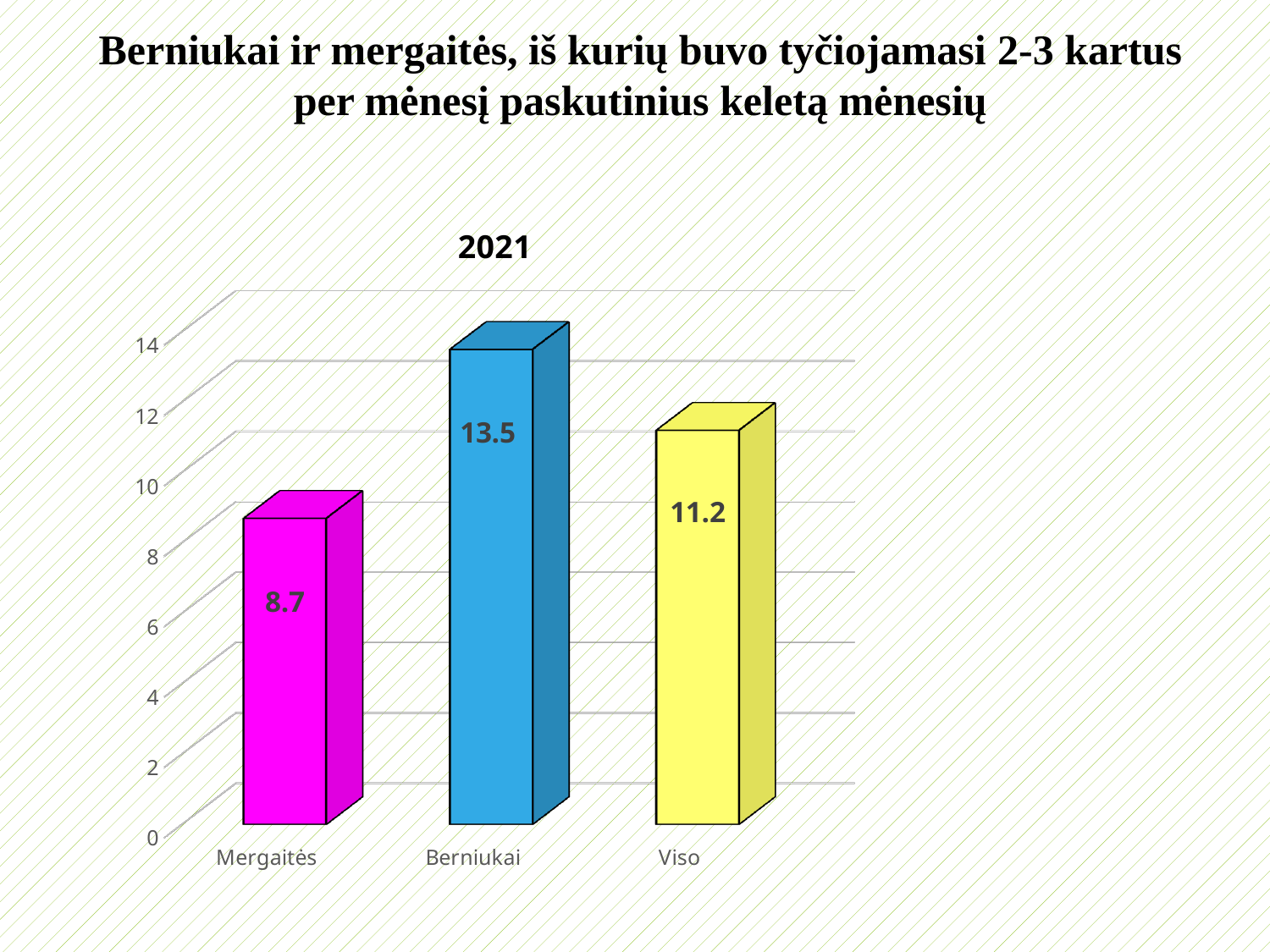
How many categories are shown on the x axis? 3 What is the value for Mergaitės? 8.7 What is the value for Berniukai? 13.5 What kind of chart is shown on the slide? bar chart Is the value for Berniukai greater or less than 12? greater Which category has the highest value? Berniukai What is the value for Viso? 11.2 What is the difference between the values for Viso and Mergaitės? 2.5 Which is larger, the value for Viso or the value for Mergaitės? Viso Which category has the lowest value? Mergaitės What is the title shown above the chart? 2021 What is the difference between the values for Berniukai and Mergaitės? 4.8